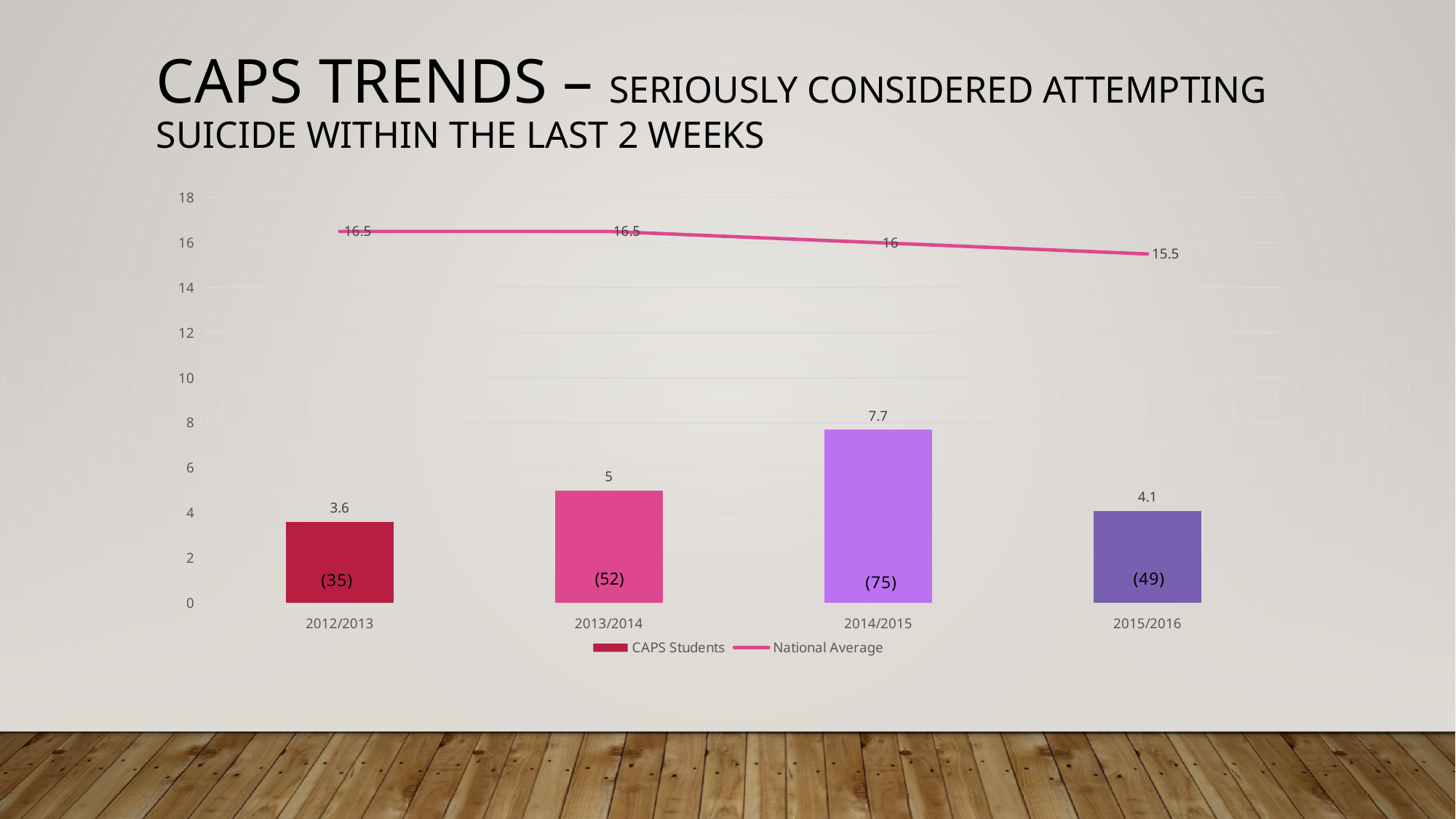
What is the National Average value for 2015/2016? 15.5 What is the difference between the National Average values for 2012/2013 and 2015/2016? 1 What is the difference between the CAPS Students values for 2014/2015 and 2013/2014? 2.7 How many years are shown on the x axis? 4 Does the National Average rise or fall from 2012/2013 to 2015/2016? fall What number is printed inside the 2014/2015 bar? (75) What is the CAPS Students value for 2012/2013? 3.6 What is the CAPS Students value for 2014/2015? 7.7 Which year has the lowest CAPS Students value? 2012/2013 How many series does the legend list? 2 Which is larger, the CAPS Students value for 2013/2014 or for 2015/2016? 2013/2014 Which year has the highest CAPS Students value? 2014/2015